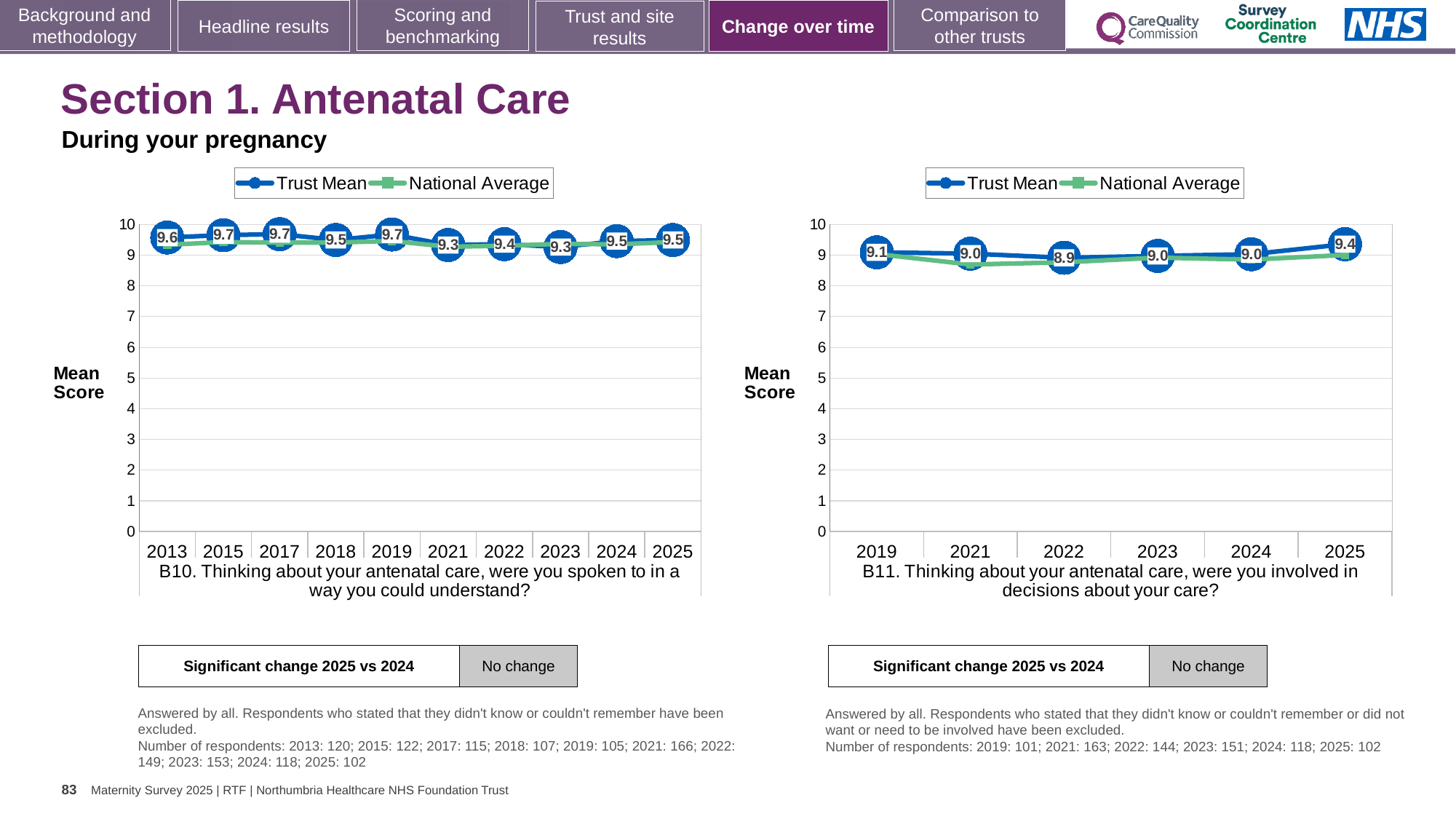
In the B10 chart (left), what is the Trust Mean for 2013? 9.6 What type of chart is the B11 chart (right)? Line chart How many series does the legend of the B11 chart (right) list? 2 In the B11 chart (right), what is the Trust Mean for 2022? 8.9 In the B11 chart (right), which year has the highest Trust Mean? 2025 In the B10 chart (left), is the Trust Mean for 2017 larger or smaller than the Trust Mean for 2023? larger In the B10 chart (left), what is the difference between the Trust Mean for 2019 and 2021? 0.4 In the B11 chart (right), which year has the lowest Trust Mean? 2022 How many years are shown on the x axis of the B10 chart (left)? 10 In the B11 chart (right), what is the Trust Mean for 2025? 9.4 In the B11 chart (right), what is the difference between the Trust Mean for 2025 and 2024? 0.4 In the B10 chart (left), what is the Trust Mean for 2025? 9.5